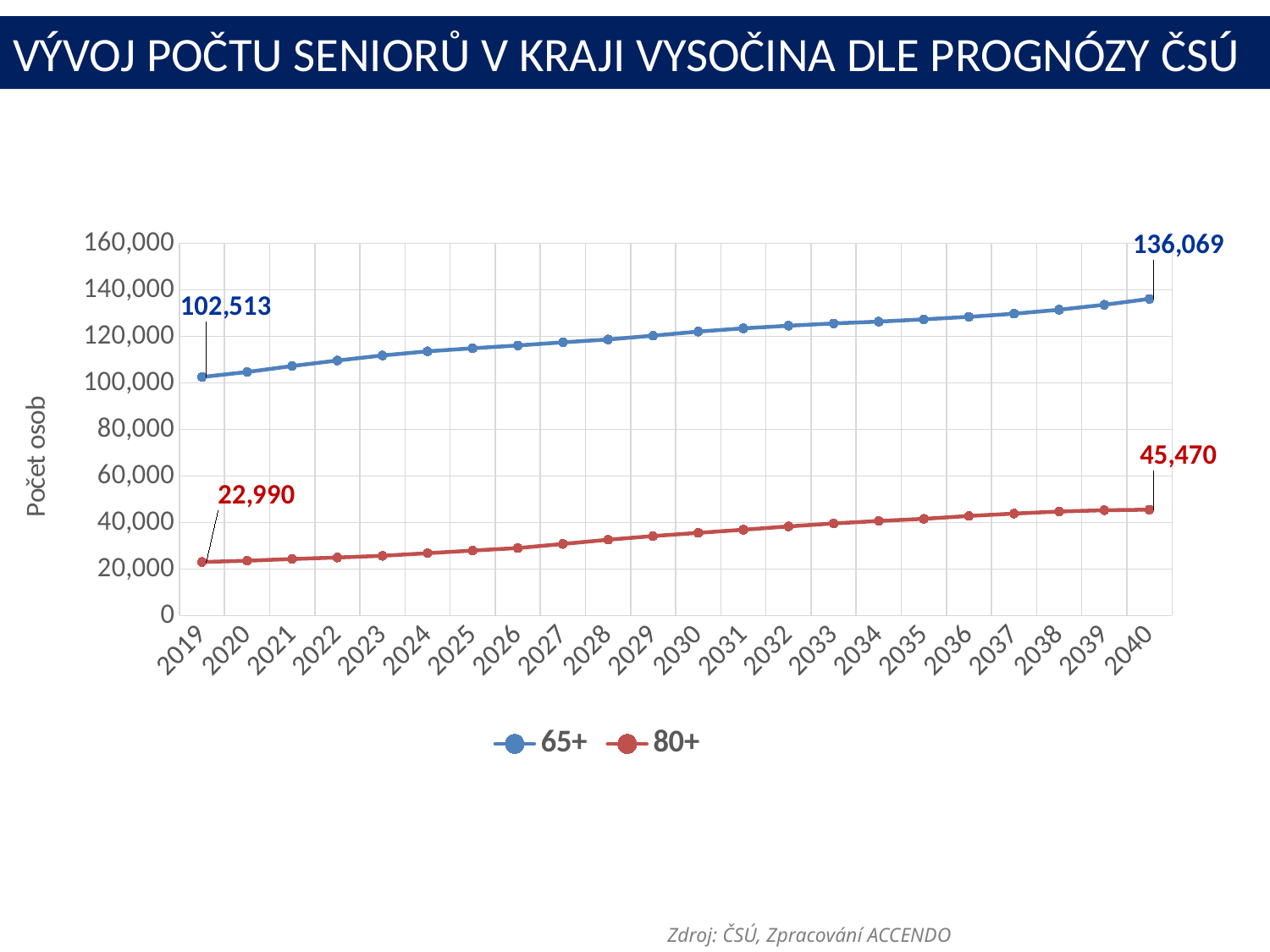
What is the value for the 80+ series in 2040? 45,470 What is the value for the 65+ series in 2040? 136,069 What is the difference between the 65+ and 80+ values in 2040? 90,599 What is the value for the 65+ series in 2019? 102,513 Is the value for the 80+ series in 2030 greater or less than 40,000? less How many series does the legend list? 2 By how much does the 80+ series increase between 2019 and 2040? 22,480 What is the value for the 80+ series in 2019? 22,990 Which series has the higher value in 2030, 65+ or 80+? 65+ What kind of chart is shown on the slide? line chart By how much does the 65+ series increase between 2019 and 2040? 33,556